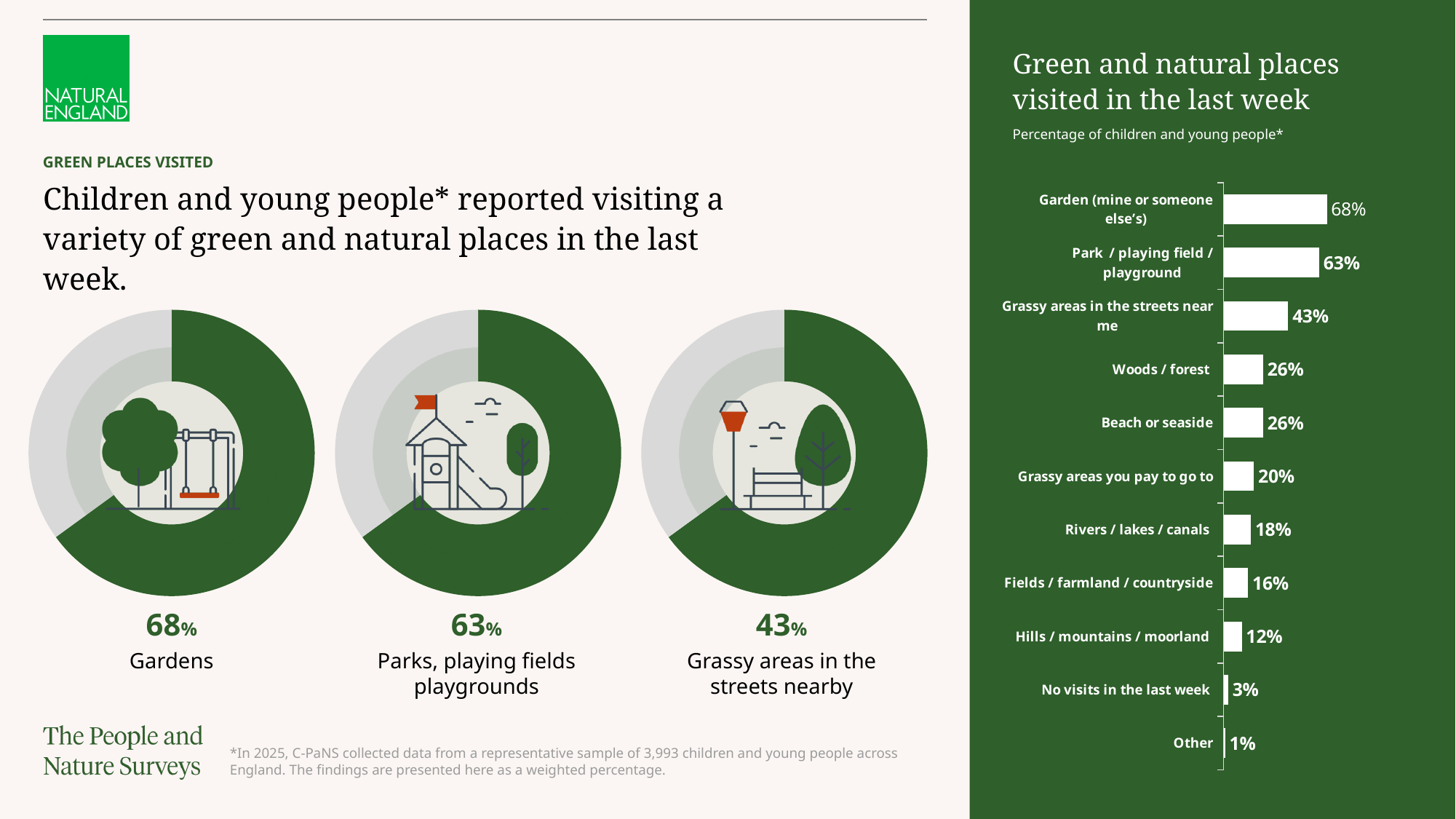
What is the subtitle printed under the title of the bar chart 'Green and natural places visited in the last week'? Percentage of children and young people* In the middle donut chart on the left of the slide, what percentage is shown for Parks, playing fields, playgrounds? 63% How many categories does the bar chart 'Green and natural places visited in the last week' show? 11 What kind of chart is the chart titled 'Green and natural places visited in the last week'? Bar chart In the bar chart 'Green and natural places visited in the last week', which is larger: Grassy areas you pay to go to or Fields / farmland / countryside? Grassy areas you pay to go to In the bar chart 'Green and natural places visited in the last week', what is the difference between the values for Garden (mine or someone else's) and Park / playing field / playground? 5% In the bar chart 'Green and natural places visited in the last week', which category has the lowest value? Other In the bar chart 'Green and natural places visited in the last week', what is the value for Woods / forest? 26% In the bar chart 'Green and natural places visited in the last week', which category has the highest value? Garden (mine or someone else's) In the bar chart 'Green and natural places visited in the last week', what is the value for No visits in the last week? 3% In the bar chart 'Green and natural places visited in the last week', what is the value for Rivers / lakes / canals? 18% In the bar chart 'Green and natural places visited in the last week', what is the value for Hills / mountains / moorland? 12%